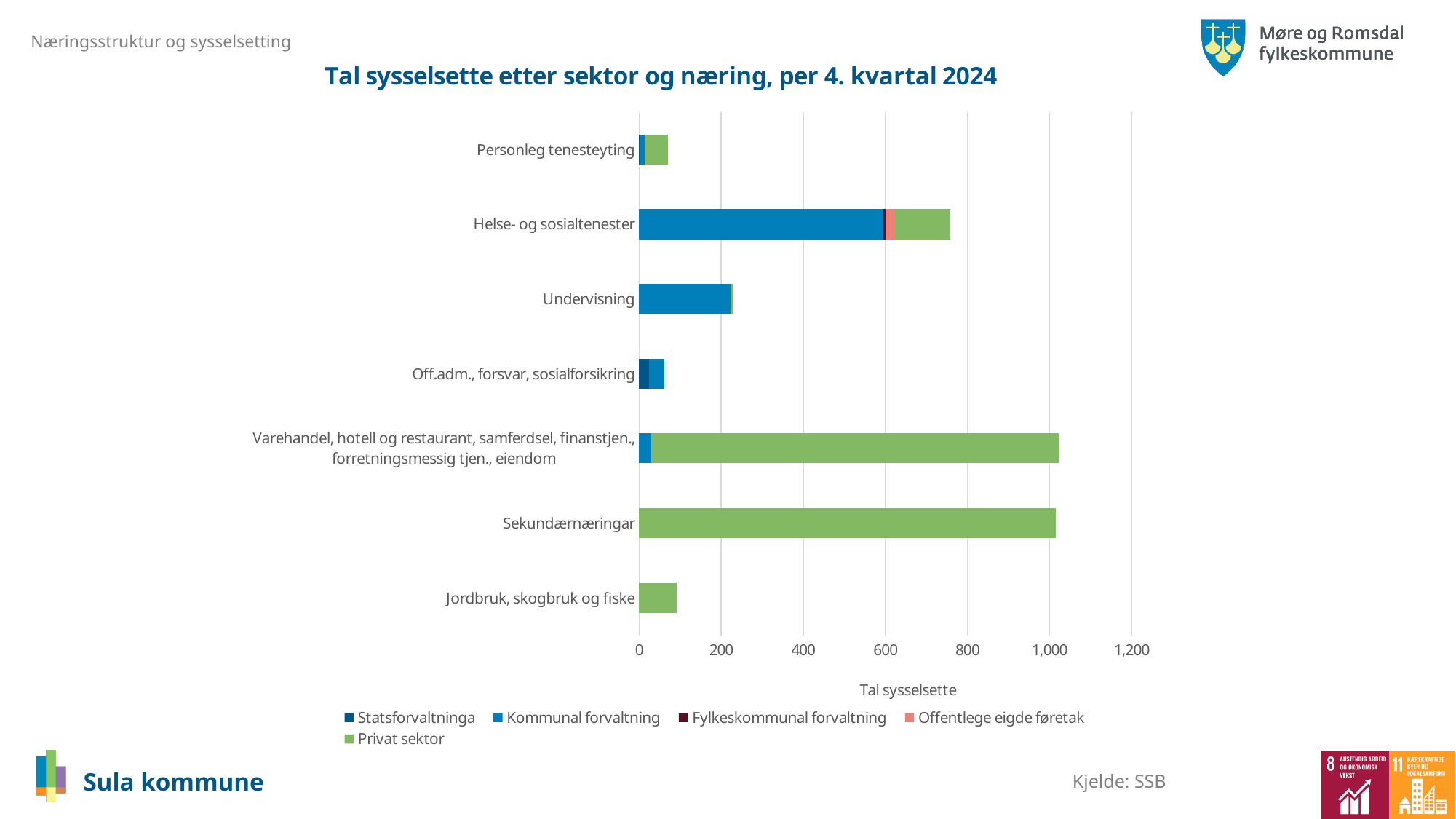
Is the total value for Off.adm., forsvar, sosialforsikring greater or less than 200? less Which has the larger bar: Jordbruk, skogbruk og fiske or Sekundærnæringar? Sekundærnæringar What is the title of the chart? Tal sysselsette etter sektor og næring, per 4. kvartal 2024 Is the value for Sekundærnæringar greater or less than 800? greater Is the total value for Helse- og sosialtenester greater or less than 600? greater Which has the larger total bar: Helse- og sosialtenester or Undervisning? Helse- og sosialtenester How many categories (næringar) are shown on the y axis of the chart? 7 Which series in the legend is shown in green? Privat sektor What kind of chart is shown on the slide? bar chart How many series does the chart legend list? 5